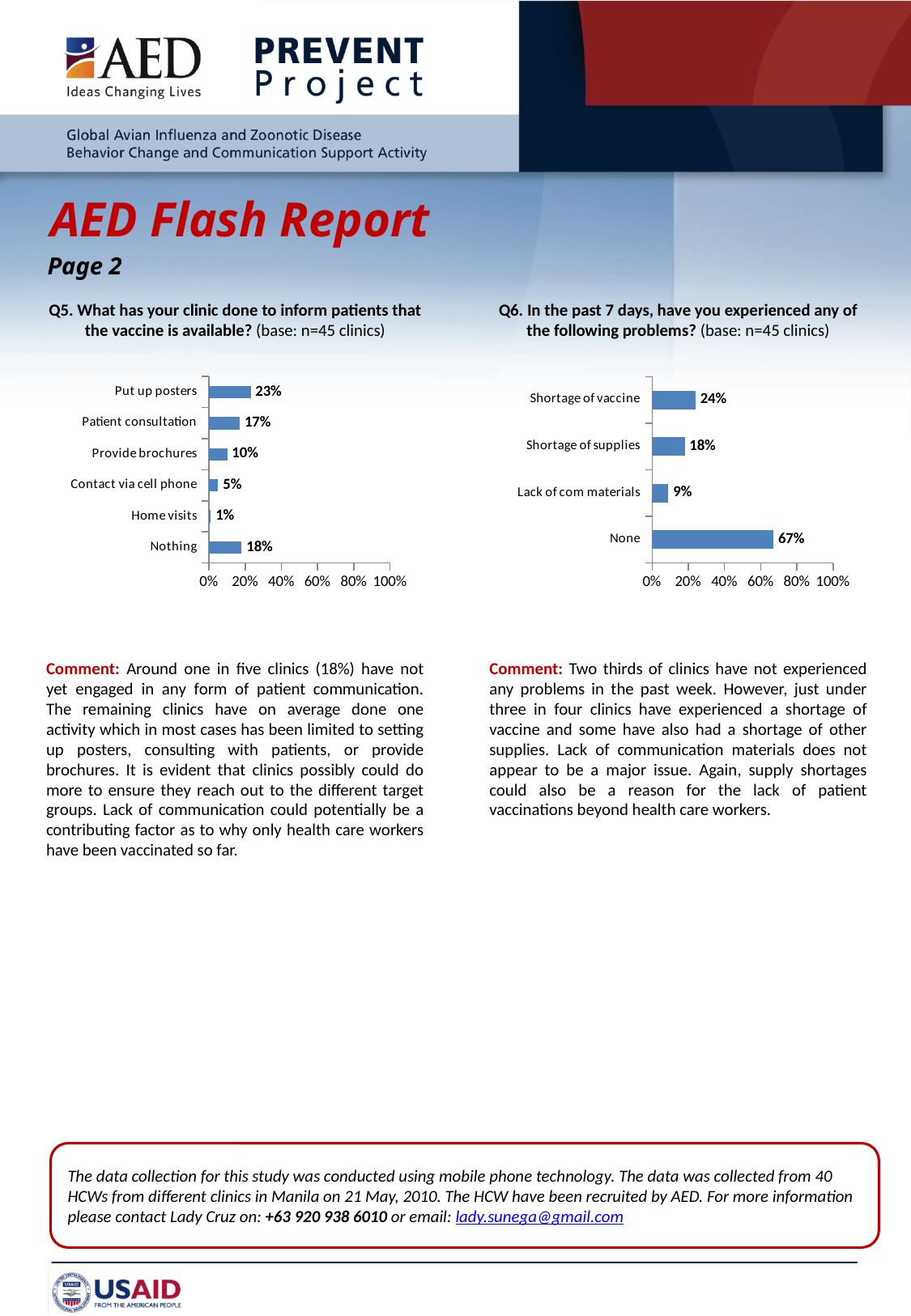
In the Q5 chart (left), how many categories are shown? 6 In the Q5 chart (left), what is the difference between Patient consultation and Provide brochures? 7% In the Q6 chart (right), which is larger: Shortage of supplies or Lack of com materials? Shortage of supplies In the Q5 chart (left), what percentage of clinics put up posters? 23% In the Q5 chart (left), which category has the highest value? Put up posters In the Q6 chart (right), how many categories are shown? 4 In the Q6 chart (right), what is the difference between None and Shortage of vaccine? 43% In the Q5 chart (left), what percentage of clinics did nothing to inform patients? 18% In the Q6 chart (right), which category has the highest value? None What type of chart is used for Q6 (right)? Bar chart In the Q5 chart (left), which category has the lowest value? Home visits In the Q6 chart (right), what percentage of clinics reported a shortage of vaccine? 24%